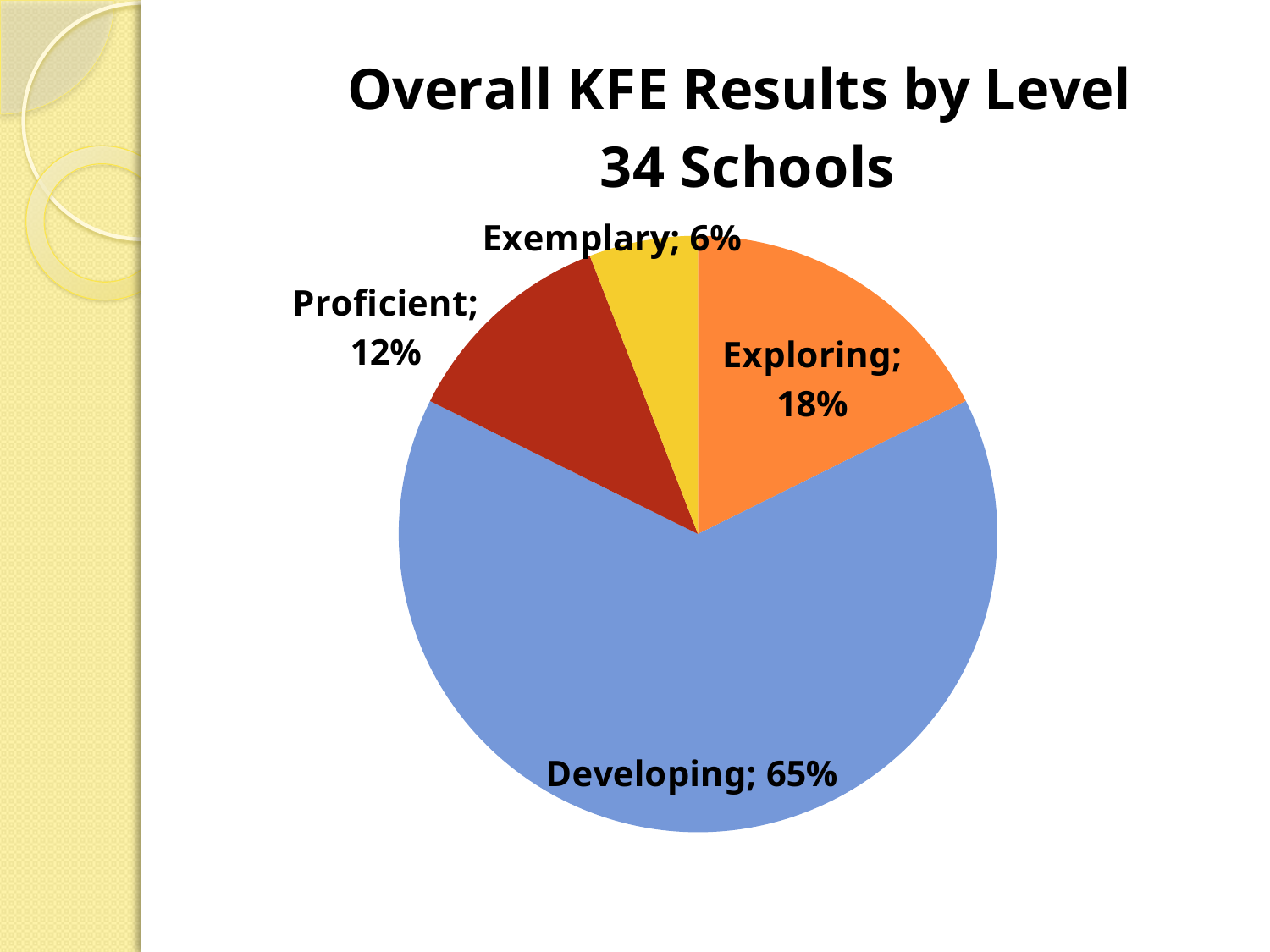
How many levels (slices) are shown in the pie chart? 4 What percentage of schools are at the Exemplary level? 6% What kind of chart is shown on the slide? pie chart Which is larger, the Proficient slice or the Exemplary slice? Proficient What percentage of schools are at the Proficient level? 12% What is the difference in percentage points between the Developing and Exploring slices? 47 What colour is the Developing slice? blue What percentage of schools are at the Exploring level? 18% Which level has the smallest share of schools? Exemplary Which level has the largest share of schools? Developing What percentage of schools are at the Developing level? 65% What is the title of the chart? Overall KFE Results by Level 34 Schools